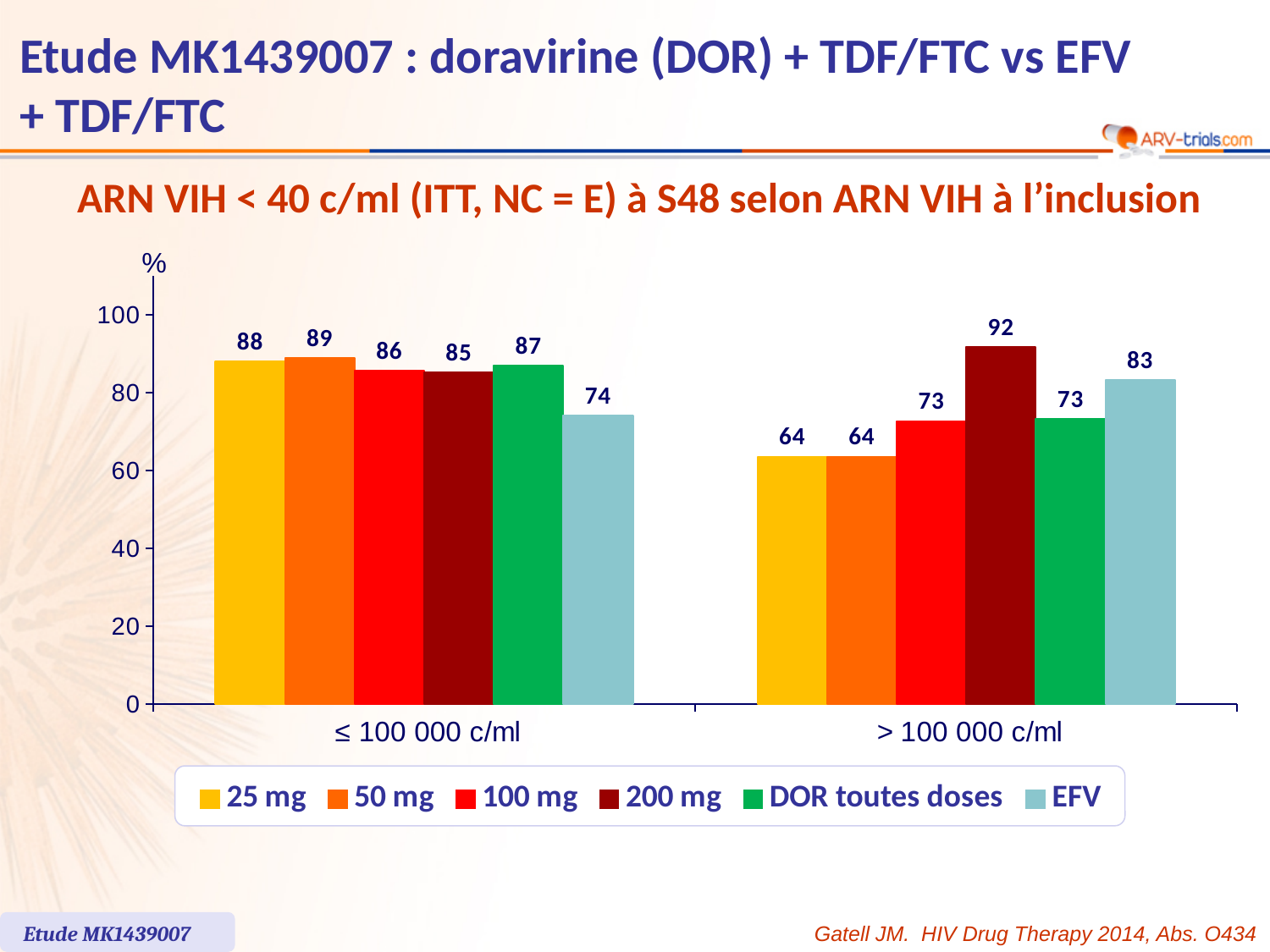
How many series does the legend list? 6 What is the value for EFV in the ≤ 100 000 c/ml group? 74 Is the value for 25 mg in the > 100 000 c/ml group greater or less than 80? less Which series has the highest value in the > 100 000 c/ml group? 200 mg How many categories are shown on the x axis? 2 What is the value for DOR toutes doses in the ≤ 100 000 c/ml group? 87 Which is larger in the ≤ 100 000 c/ml group: the 50 mg value or the EFV value? 50 mg What unit is shown on the y axis? % What kind of chart is shown on the slide? bar chart What is the value for 200 mg in the > 100 000 c/ml group? 92 What is the difference between the 200 mg value and the EFV value in the > 100 000 c/ml group? 9 Which series has the lowest value in the ≤ 100 000 c/ml group? EFV